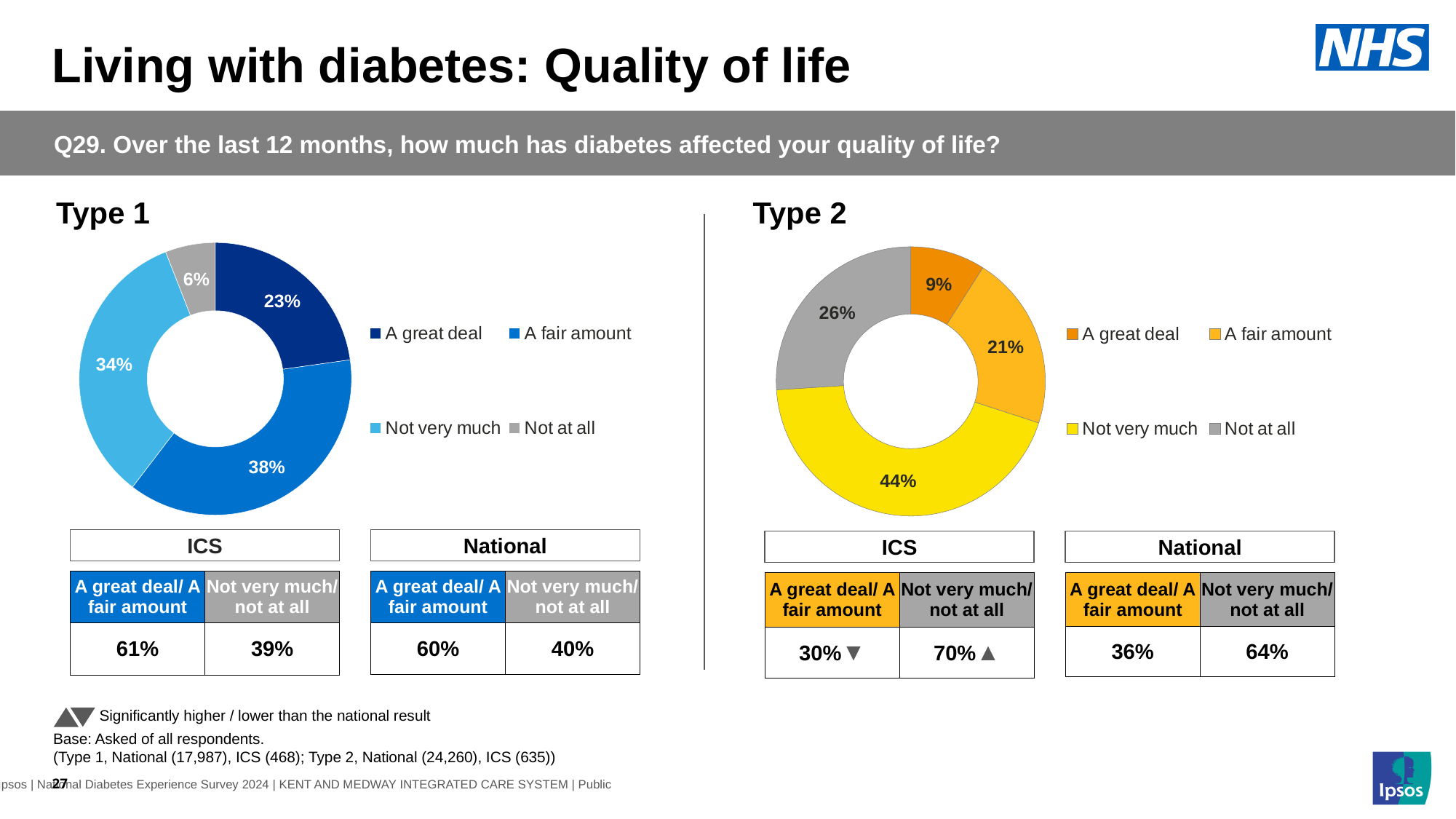
In the Type 1 chart, what percentage said 'Not at all'? 6% What kind of chart is used for Type 1? Doughnut (pie) chart In the Type 2 chart, which response category has the smallest share? A great deal In the Type 2 chart, which colour represents 'Not very much'? Yellow In the Type 1 chart, what percentage of respondents said diabetes affected their quality of life 'A fair amount'? 38% In the Type 2 chart, what is the difference between the 'Not very much' and 'Not at all' shares? 18 percentage points In the Type 1 chart, what is the difference between the 'A fair amount' and 'Not very much' shares? 4 percentage points How many response categories does the Type 2 chart show? 4 In the Type 1 chart, which response category has the largest share? A fair amount Which is larger in the Type 1 chart: the 'A great deal' share or the 'Not very much' share? Not very much In the Type 2 chart, what percentage said 'A great deal'? 9% In the Type 2 chart, what percentage of respondents said 'Not very much'? 44%